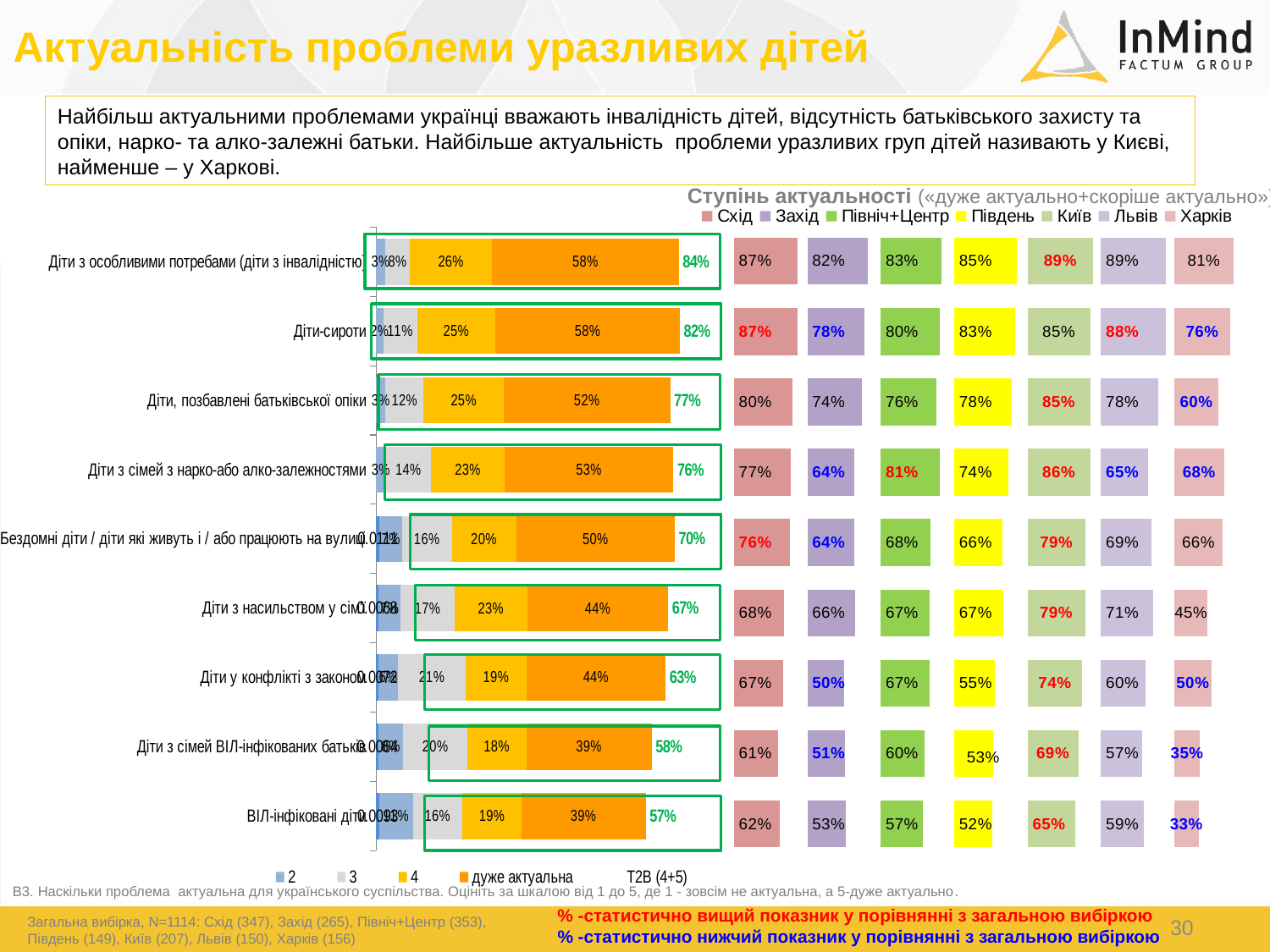
In the regional table, what is the Харків value for ВІЛ-інфіковані діти? 33% Which category has the lowest T2B (4+5) value? ВІЛ-інфіковані діти How many entries does the legend of the bar chart list? 5 Do the T2B (4+5) values rise or fall going from the top category to the bottom category? Fall What is the value of the "3" segment for Діти з сімей з нарко-або алко-залежностями? 14% How many categories (groups of children) are shown in the bar chart? 9 Which category has the highest T2B (4+5) value? Діти з особливими потребами (діти з інвалідністю) Which has a larger "4" segment: Діти-сироти or Бездомні діти / діти які живуть і / або працюють на вулиці? Діти-сироти What is the "дуже актуальна" value for Діти-сироти? 58% What type of chart is used to show the degree of relevance of each problem? Stacked bar chart What is the T2B (4+5) value for Діти у конфлікті з законом? 63% What is the difference between the T2B (4+5) values for Діти з особливими потребами (діти з інвалідністю) and ВІЛ-інфіковані діти? 27 percentage points